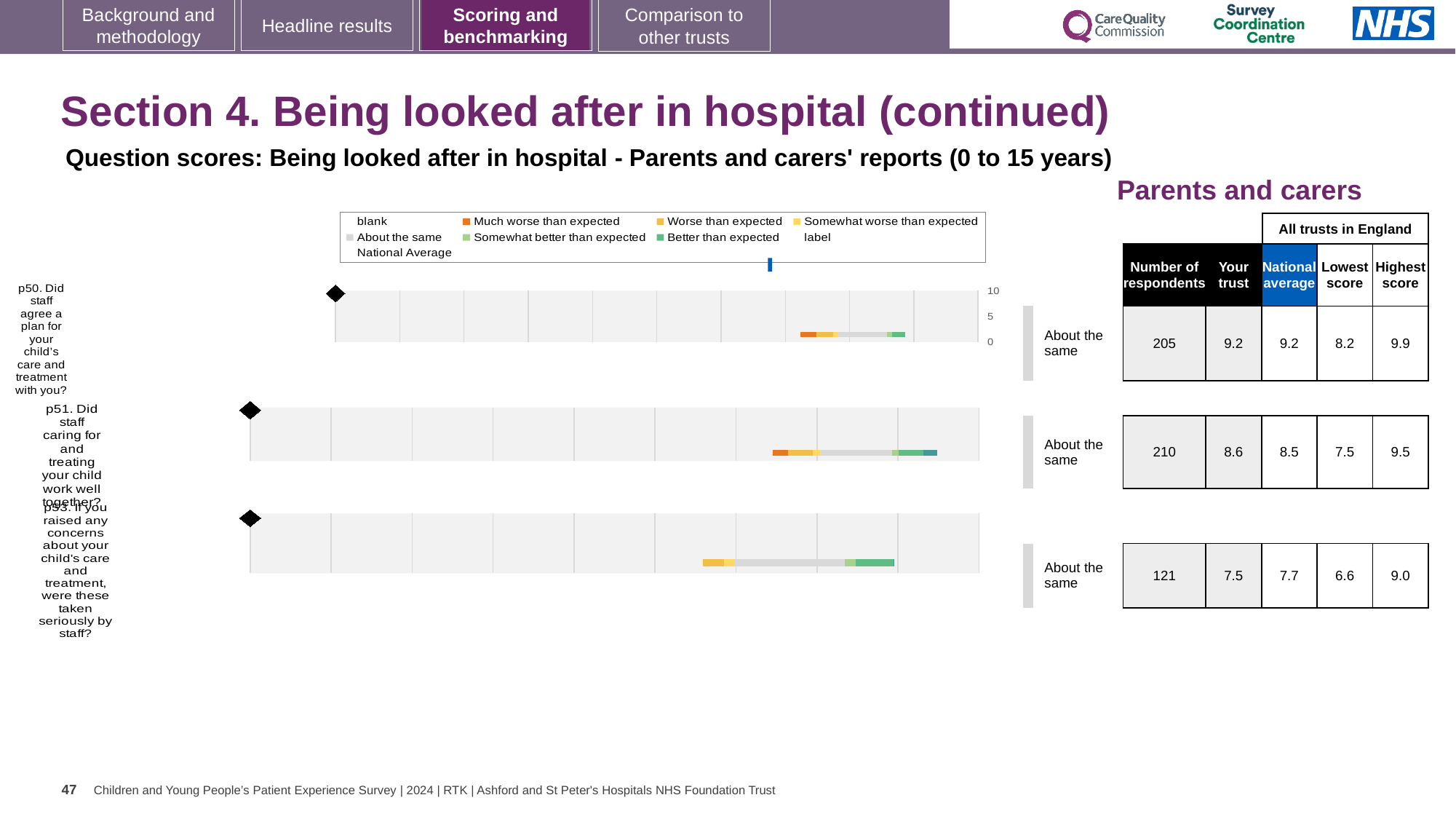
What colour does the legend use for 'Much worse than expected'? Orange What is the highest score among all trusts in England for p50? 9.9 For p53, which is larger: the 'Your trust' score or the national average? National average How many respondents answered p53 (If you raised any concerns about your child's care and treatment, were these taken seriously by staff?)? 121 How many questions are charted on this slide? 3 What benchmark category is shown for p50? About the same Which question has the highest 'Your trust' score on this slide? p50 What is the 'Your trust' score for p50 (Did staff agree a plan for your child's care and treatment with you?)? 9.2 Which question has the lowest 'Lowest score' among all trusts in England? p53 For p51, what is the difference between the 'Your trust' score and the national average? 0.1 For p53, what is the difference between the highest score and the lowest score among all trusts in England? 2.4 What is the national average score for p51 (Did staff caring for and treating your child work well together?)? 8.5